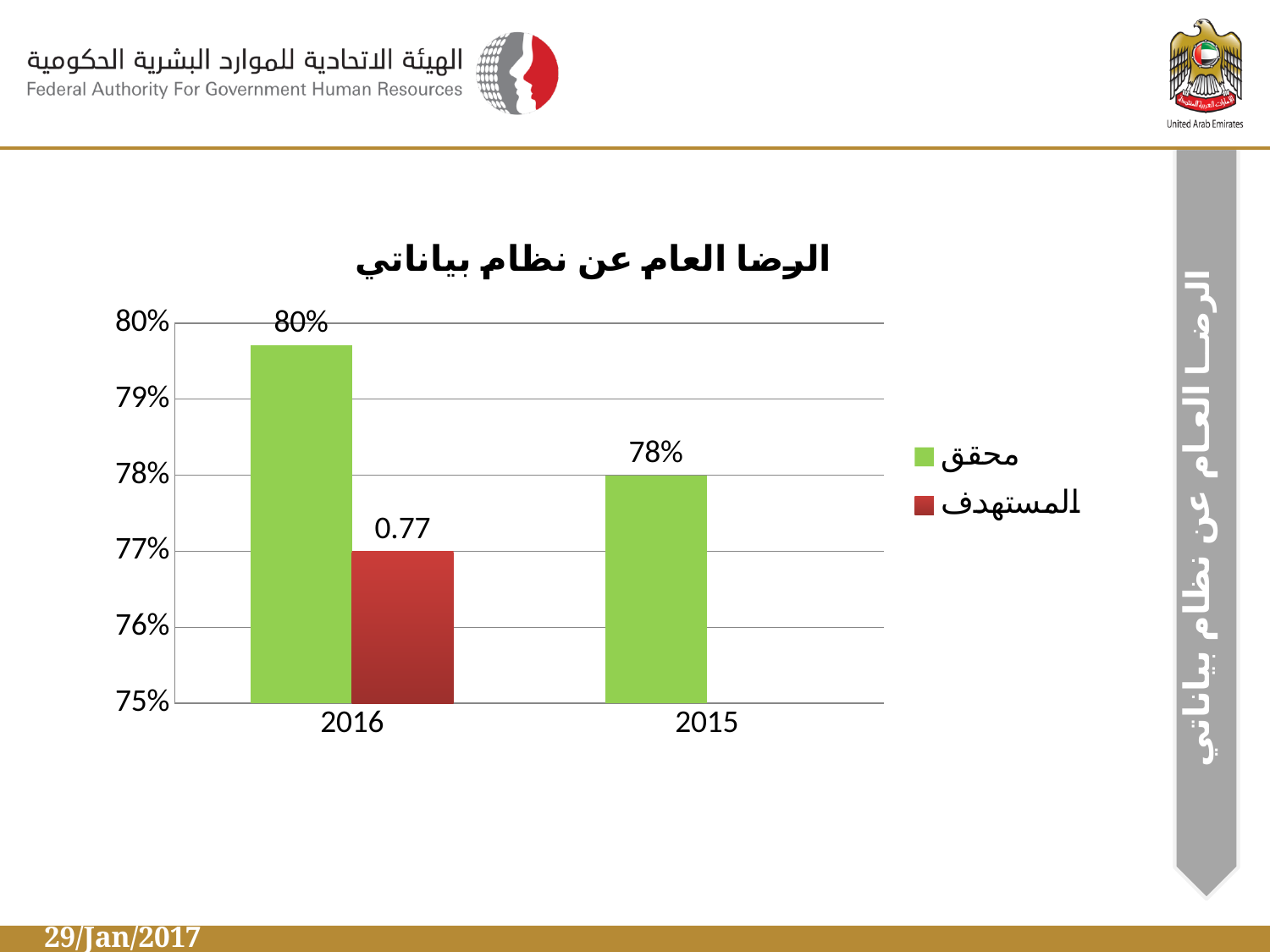
Is the المستهدف (target) value for 2016 greater or less than 78%? less How many series does the chart legend list? 2 What is the value of the محقق (achieved) bar for 2015? 78% What is the difference between the محقق (achieved) values for 2016 and 2015? 2% What colour represents the محقق (achieved) series in the legend? green Which year has the higher محقق (achieved) value? 2016 Is the محقق (achieved) value larger for 2016 or for 2015? 2016 How many years are shown on the x axis of the chart? 2 What is the value of the المستهدف (target) bar for 2016? 0.77 What is the value of the محقق (achieved) bar for 2016? 80% What kind of chart is shown on the slide? bar chart Which year has the lower محقق (achieved) value? 2015